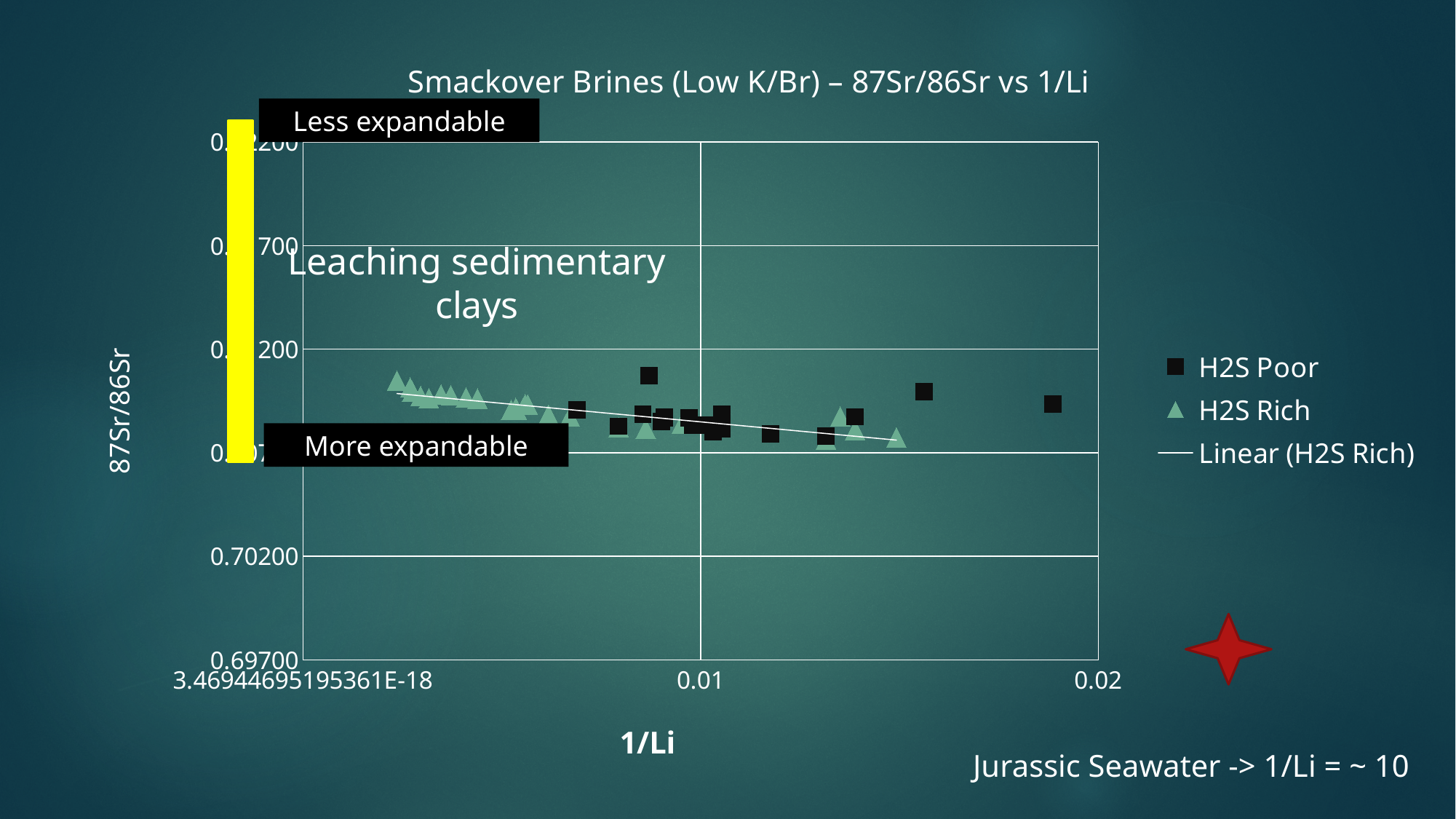
How many entries does the chart legend list? 3 Which series contains the point with the largest 1/Li value? H2S Poor What kind of chart is shown on the slide? Scatter chart Which series contains the point with the smallest 1/Li value? H2S Rich What is the lowest tick label shown on the y axis? 0.69700 Is the 87Sr/86Sr value of the H2S Poor point with the largest 1/Li greater or less than 0.70200? greater Are all plotted points above or below the 0.70200 gridline? above Which series contains the point with the highest 87Sr/86Sr value? H2S Poor What is the label on the x axis of the chart? 1/Li What is the highest tick label shown on the x axis? 0.02 What is the title of the chart? Smackover Brines (Low K/Br) – 87Sr/86Sr vs 1/Li Does the Linear (H2S Rich) trendline rise or fall as 1/Li increases? Fall